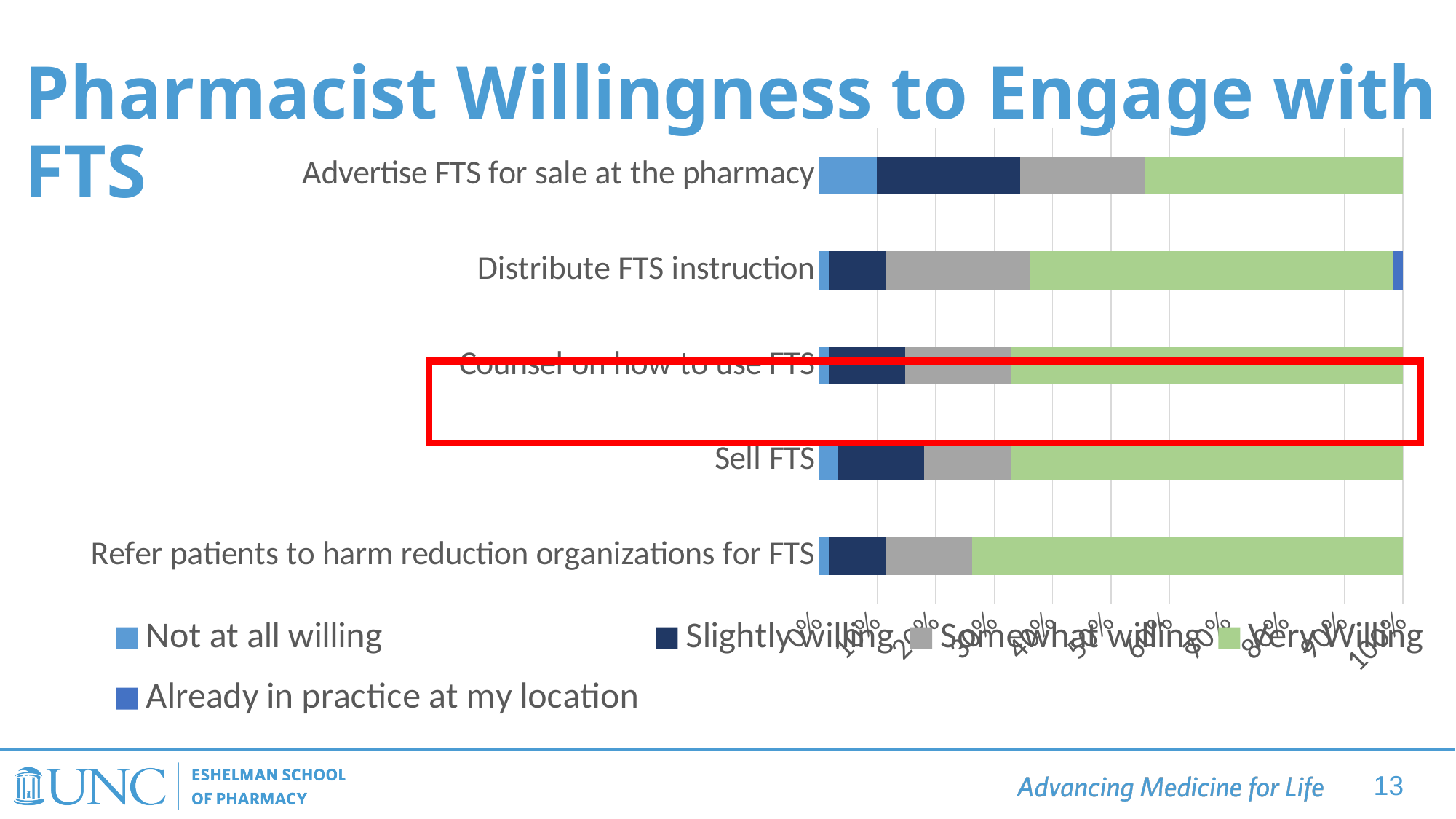
Is the 'Very Willing' share for 'Counsel on how to use FTS' greater or less than 60%? greater What kind of chart is shown on the slide? Stacked bar chart Which category has the smallest 'Very Willing' segment? Advertise FTS for sale at the pharmacy Is the 'Very Willing' share for 'Refer patients to harm reduction organizations for FTS' greater or less than 70%? greater How many categories (activities) are plotted on the chart? 5 Which category has the largest 'Not at all willing' segment? Advertise FTS for sale at the pharmacy Which legend entry is shown in green? Very Willing Is the 'Slightly willing' share for 'Advertise FTS for sale at the pharmacy' greater or less than 20%? greater Is the 'Very Willing' segment larger for 'Refer patients to harm reduction organizations for FTS' or for 'Advertise FTS for sale at the pharmacy'? Refer patients to harm reduction organizations for FTS What is the title of the slide containing the chart? Pharmacist Willingness to Engage with FTS Which category has the largest 'Very Willing' segment? Refer patients to harm reduction organizations for FTS How many series does the legend list? 5